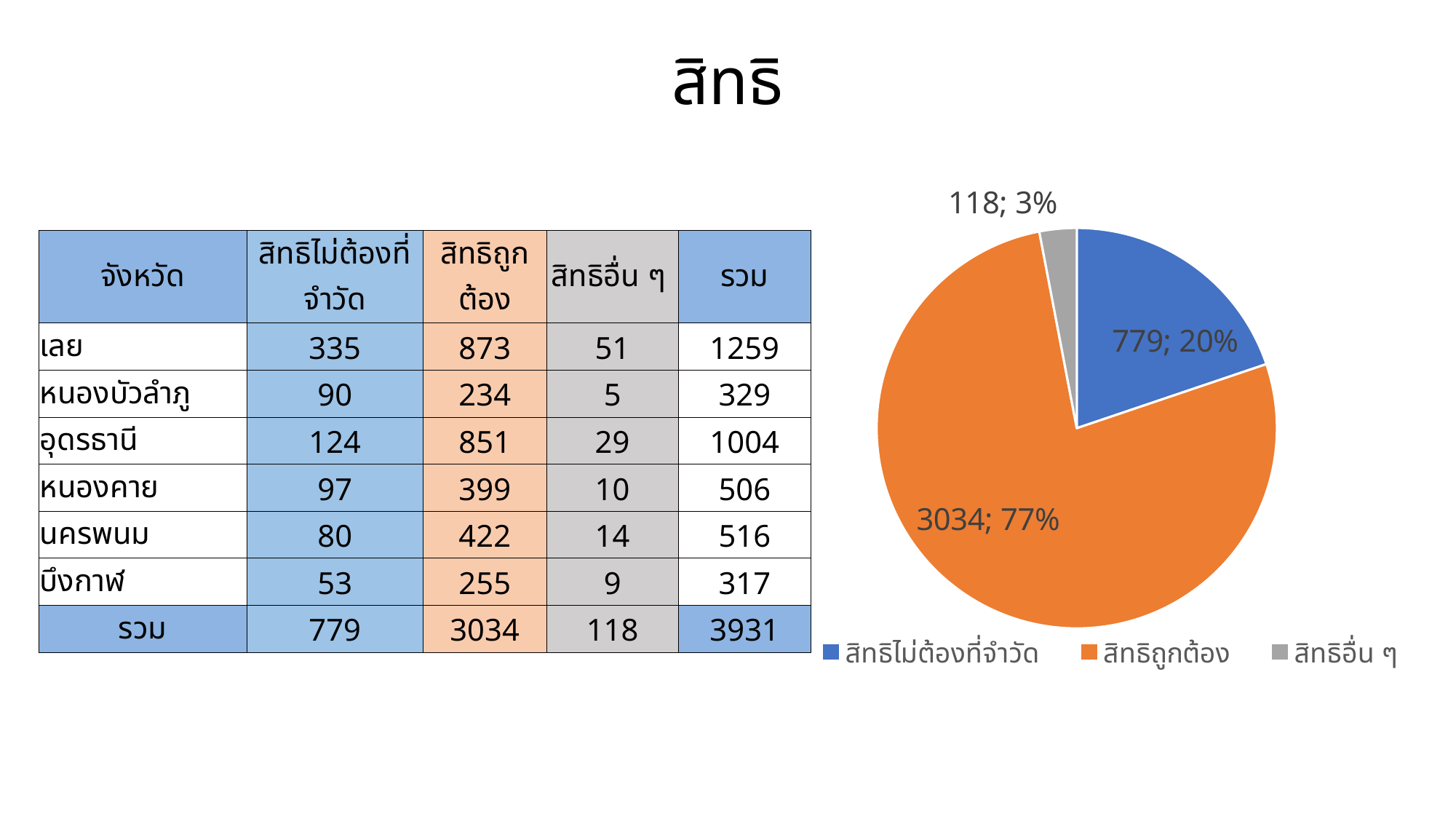
In the pie chart, what share does สิทธิถูกต้อง have? 77% In the pie chart, what is the value for สิทธิไม่ต้องที่จำวัด? 779 Which slice of the pie chart is the largest? สิทธิถูกต้อง How many slices does the pie chart have? 3 In the pie chart, what share does สิทธิไม่ต้องที่จำวัด have? 20% In the pie chart, what share does สิทธิอื่น ๆ have? 3% In the pie chart, what is the value for สิทธิอื่น ๆ? 118 In the pie chart, what is the value for สิทธิถูกต้อง? 3034 In the pie chart, what is the difference between the values for สิทธิถูกต้อง and สิทธิไม่ต้องที่จำวัด? 2255 Which slice of the pie chart is the smallest? สิทธิอื่น ๆ What kind of chart is shown on the right of the slide? pie chart In the pie chart, which colour represents สิทธิถูกต้อง? orange